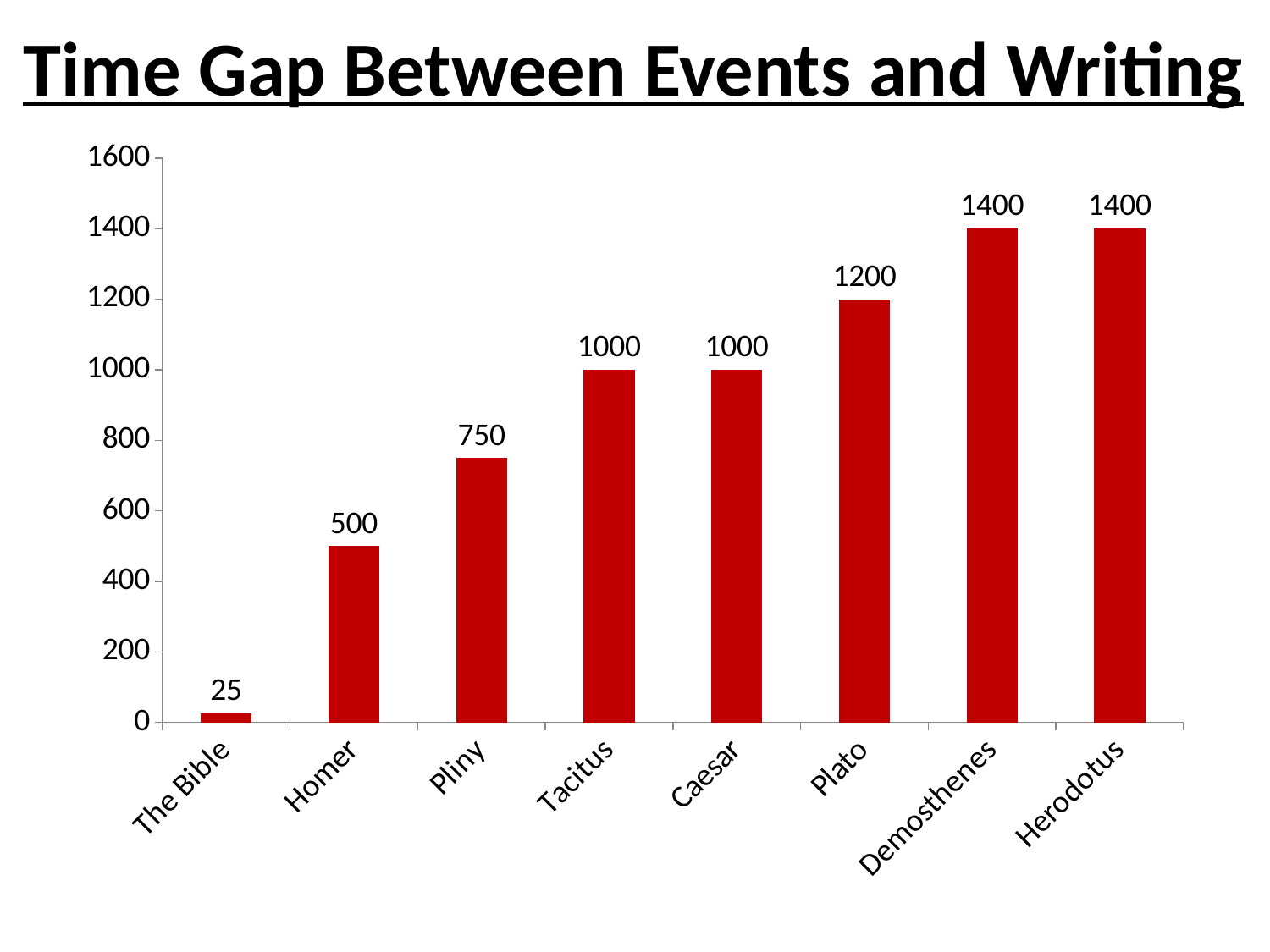
What is the difference between the values for Demosthenes and Tacitus? 400 What is the value for Plato? 1200 Is the value for Tacitus greater or less than 800? greater How many categories are shown on the x axis? 8 Which category has the lowest value? The Bible What is the difference between the values for Plato and Homer? 700 What is the value for Homer? 500 Which is larger, the value for Pliny or the value for Caesar? Caesar What is the title of the chart? Time Gap Between Events and Writing What is the value for The Bible? 25 What kind of chart is shown on the slide? Bar chart What is the value for Pliny? 750